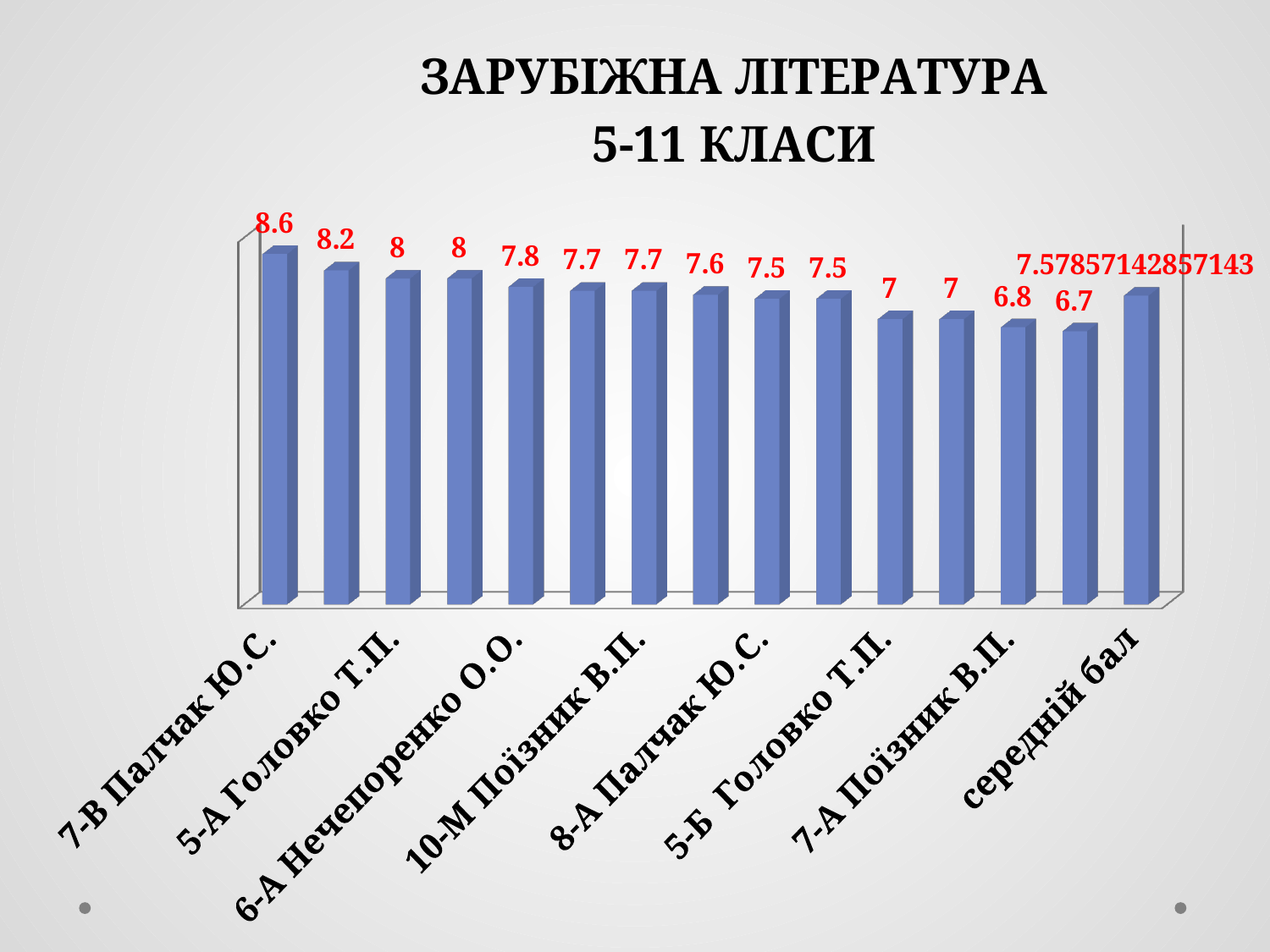
Which is larger, the value for 7-В Палчак Ю.С. or the value for 7-А Поїзник В.П.? 7-В Палчак Ю.С. How many bars are plotted in the chart? 15 What is the value for 5-А Головко Т.П.? 8 What is the value for середній бал? 7.57857142857143 What is the value for 7-В Палчак Ю.С.? 8.6 What is the value for 7-А Поїзник В.П.? 6.8 What is the difference between the highest value (8.6) and the lowest value (6.7)? 1.9 What is the title of the chart? ЗАРУБІЖНА ЛІТЕРАТУРА 5-11 КЛАСИ What type of chart is shown on the slide? bar chart What is the lowest value shown in the chart? 6.7 What is the highest value shown in the chart? 8.6 Which category has the highest value? 7-В Палчак Ю.С.